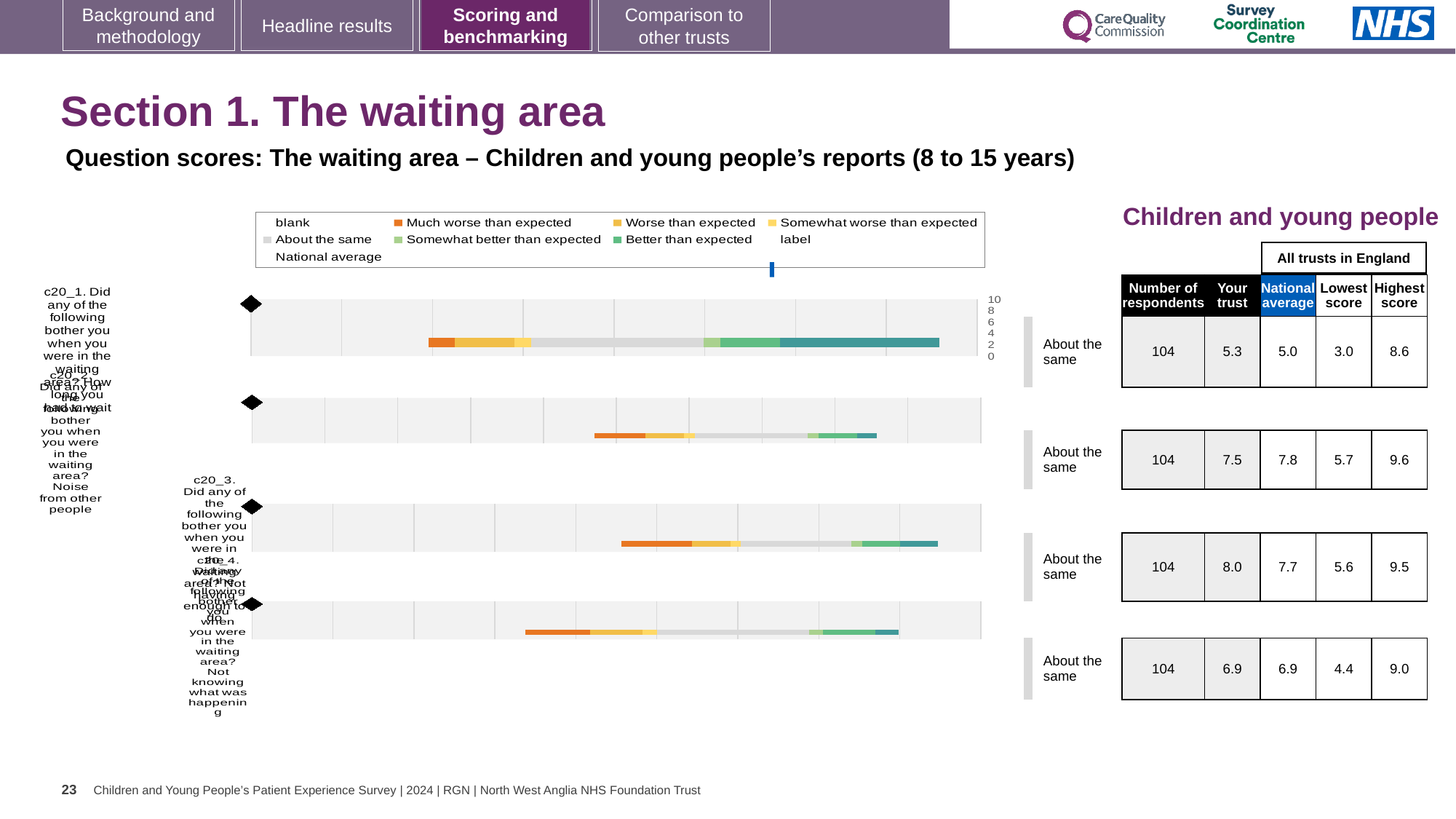
Which of the four questions has the highest 'Your trust' score? c20_3 In the legend, which colour represents 'Better than expected'? teal How many question charts (bars) are shown on the slide? 4 For the second chart (c20_2, noise from other people), what is the national average score? 7.8 For the third chart (c20_3), what is the highest score among all trusts in England? 9.5 For the first chart (c20_1), what is the 'Your trust' score shown in the table? 5.3 What kind of chart is used to show the question scores on this slide? bar chart Which of the four questions has the lowest 'Your trust' score? c20_1 In the legend, which colour represents 'Much worse than expected'? orange For the fourth chart (c20_4), what is the lowest score among all trusts in England? 4.4 For the second chart (c20_2), what is the difference between the national average and the 'Your trust' score? 0.3 How many respondents are listed for the first chart (c20_1)? 104